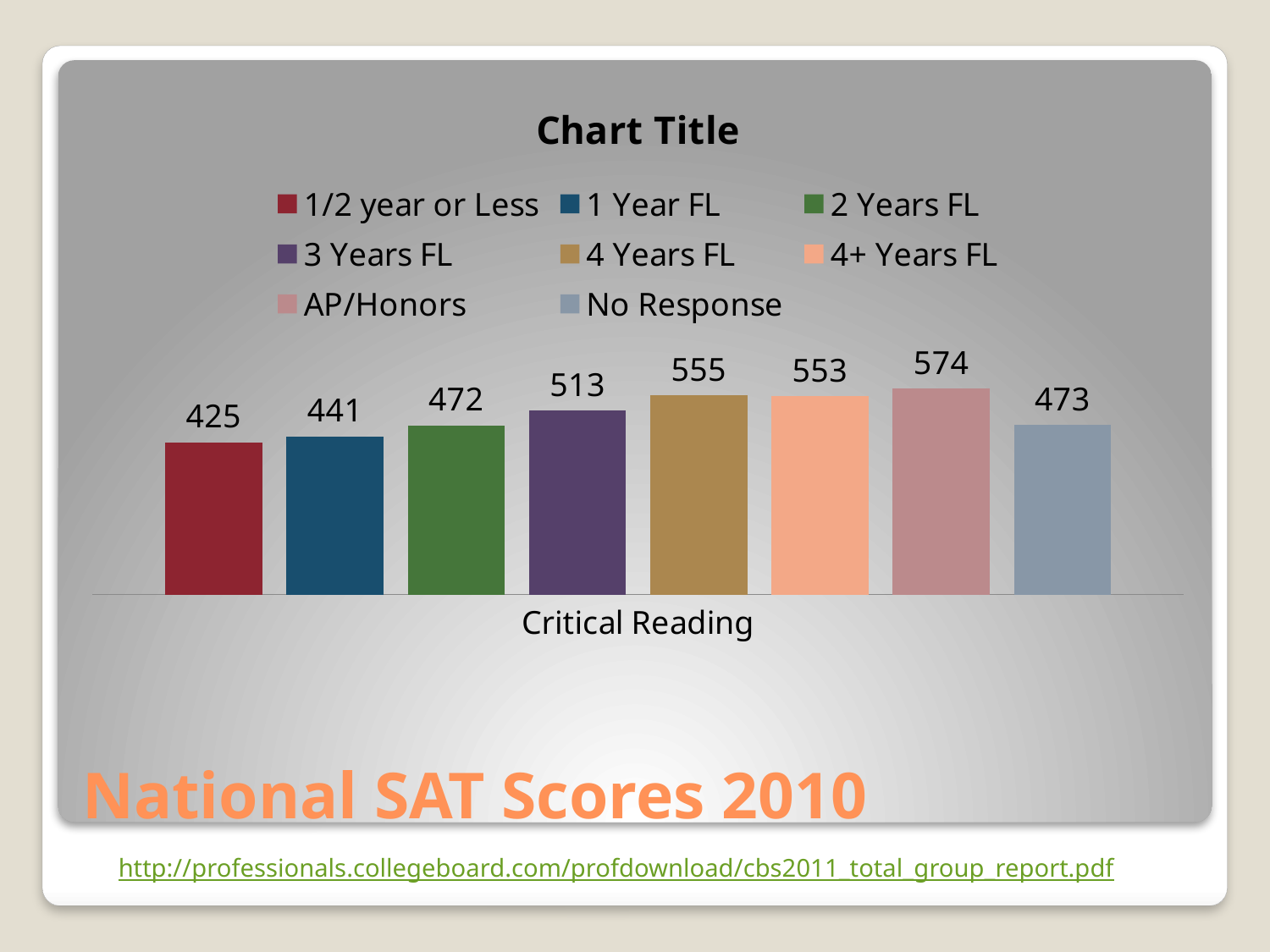
What is the title shown above the chart? Chart Title Which series has the highest Critical Reading score? AP/Honors What is the Critical Reading score for the 3 Years FL series? 513 What is the difference between the AP/Honors score and the 4+ Years FL score? 21 What is the category label shown on the x axis? Critical Reading How many series does the legend list? 8 Which series has the lowest Critical Reading score? 1/2 year or Less What kind of chart is shown on the slide? Bar chart What is the difference between the 4 Years FL score and the 1 Year FL score? 114 What is the Critical Reading score for the No Response series? 473 What is the Critical Reading score for the 1/2 year or Less series? 425 Which is larger, the score for 2 Years FL or the score for No Response? No Response